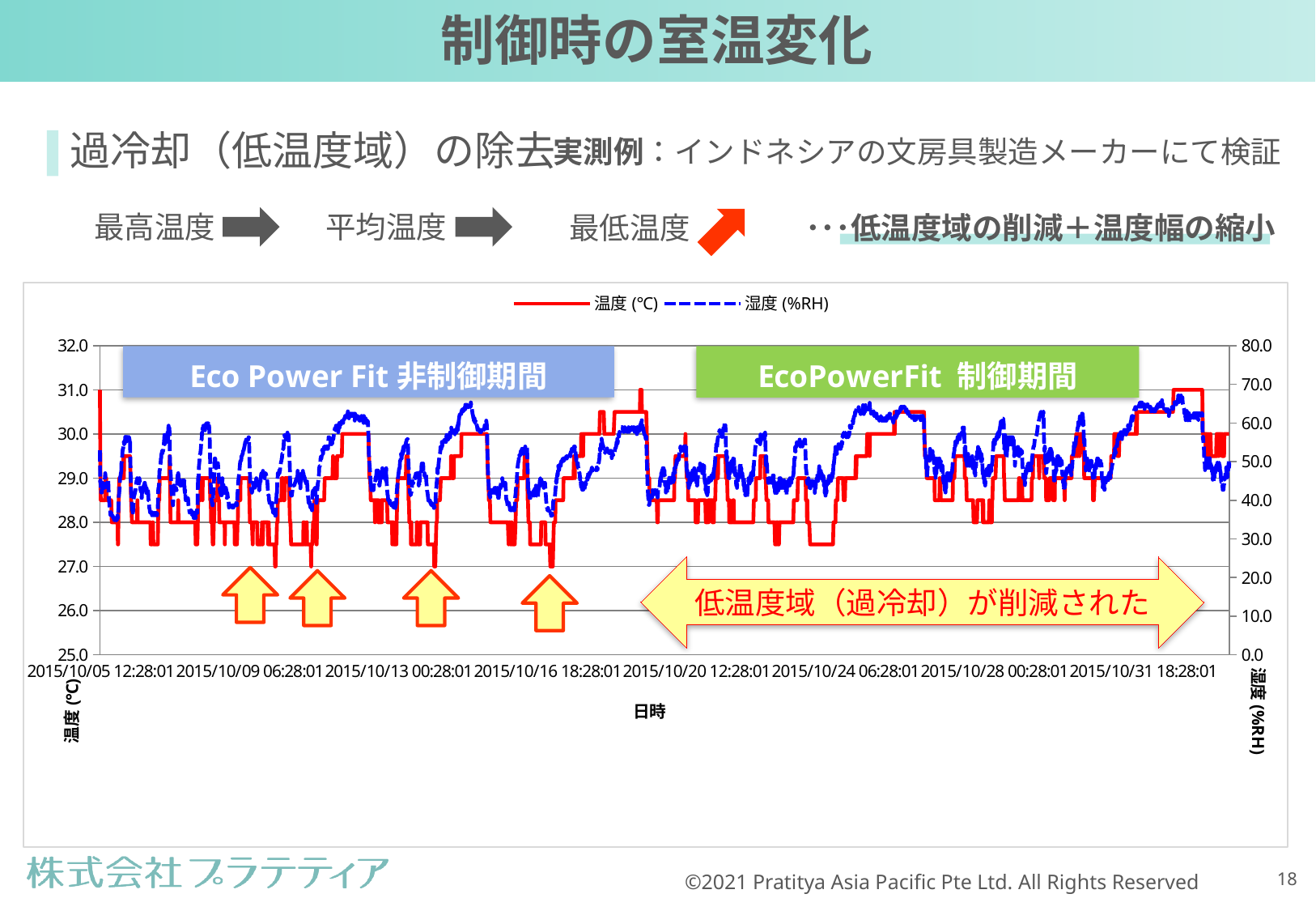
Which series is drawn as a solid red line in the chart? 温度 (°C) Is the lowest temperature value plotted in the chart greater or less than 26.0? greater How many series does the chart legend list? 2 What is the highest value shown on the right (humidity) axis of the chart? 80.0 What is the last date-time label on the x axis of the chart? 2015/10/31 18:28:01 Which series is drawn as a dashed blue line in the chart? 湿度 (%RH) What is the lowest value shown on the left (temperature) axis of the chart? 25.0 What is the first date-time label on the x axis of the chart? 2015/10/05 12:28:01 How many date-time tick labels are shown along the x axis of the chart? 8 What kind of chart is shown on the slide? line chart What is the highest value shown on the left (temperature) axis of the chart? 32.0 Is the highest temperature value plotted in the chart greater or less than 32.0? less